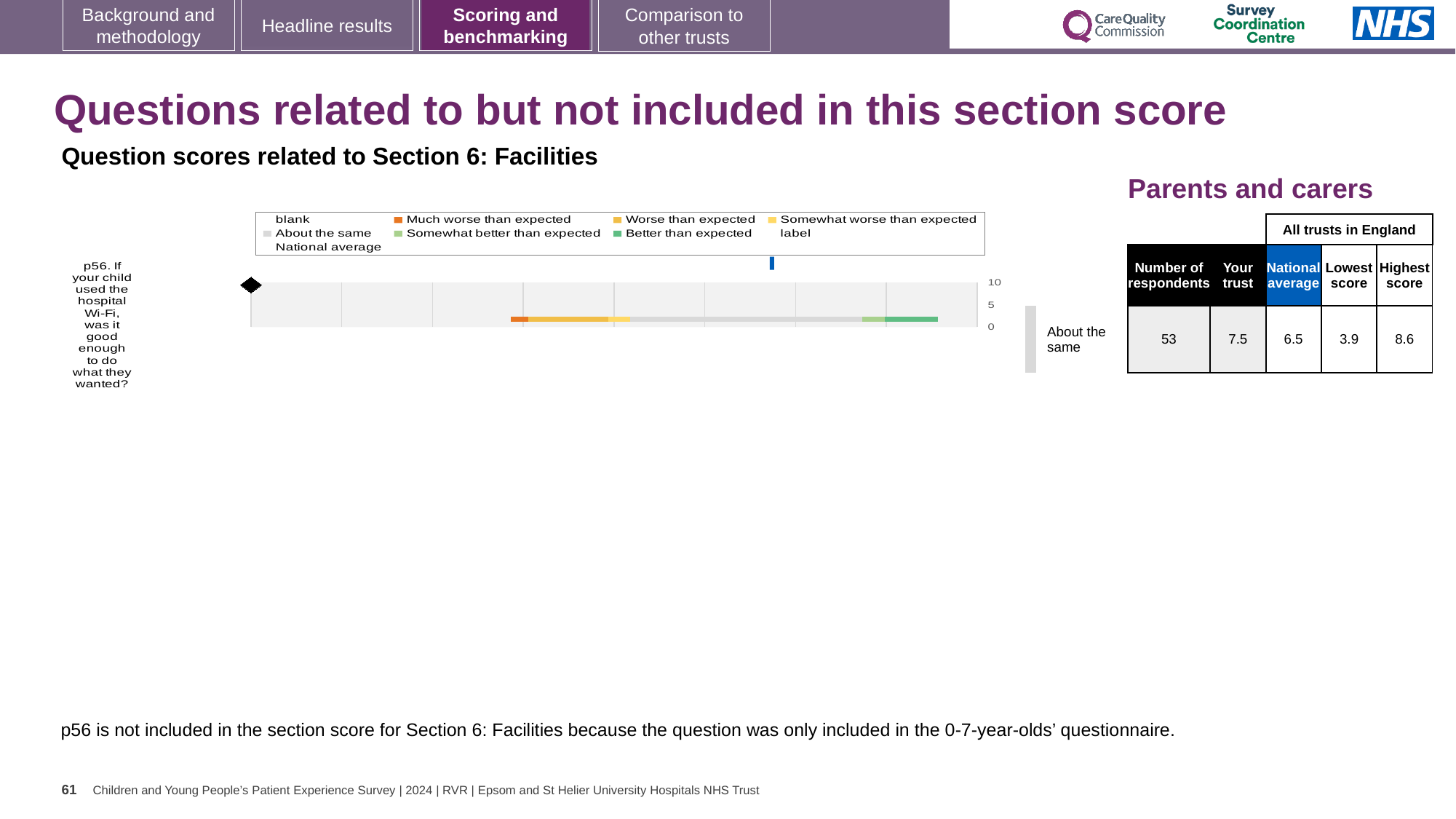
How many respondents answered p56? 53 What colour represents 'Much worse than expected' in the chart legend? orange Which benchmark category is the trust's p56 result placed in? About the same What is the highest score among all trusts in England for p56? 8.6 What is the national average score for p56? 6.5 What is the difference between the trust's score and the national average for p56? 1.0 Is the trust's score for p56 greater or less than 5 on the chart axis? greater What kind of chart is used to show the p56 question score? bar chart How many questions are plotted in the chart? 1 Which is larger for p56, the trust's score or the national average? Your trust What is the 'Your trust' score for p56 in the table? 7.5 What is the lowest score among all trusts in England for p56? 3.9